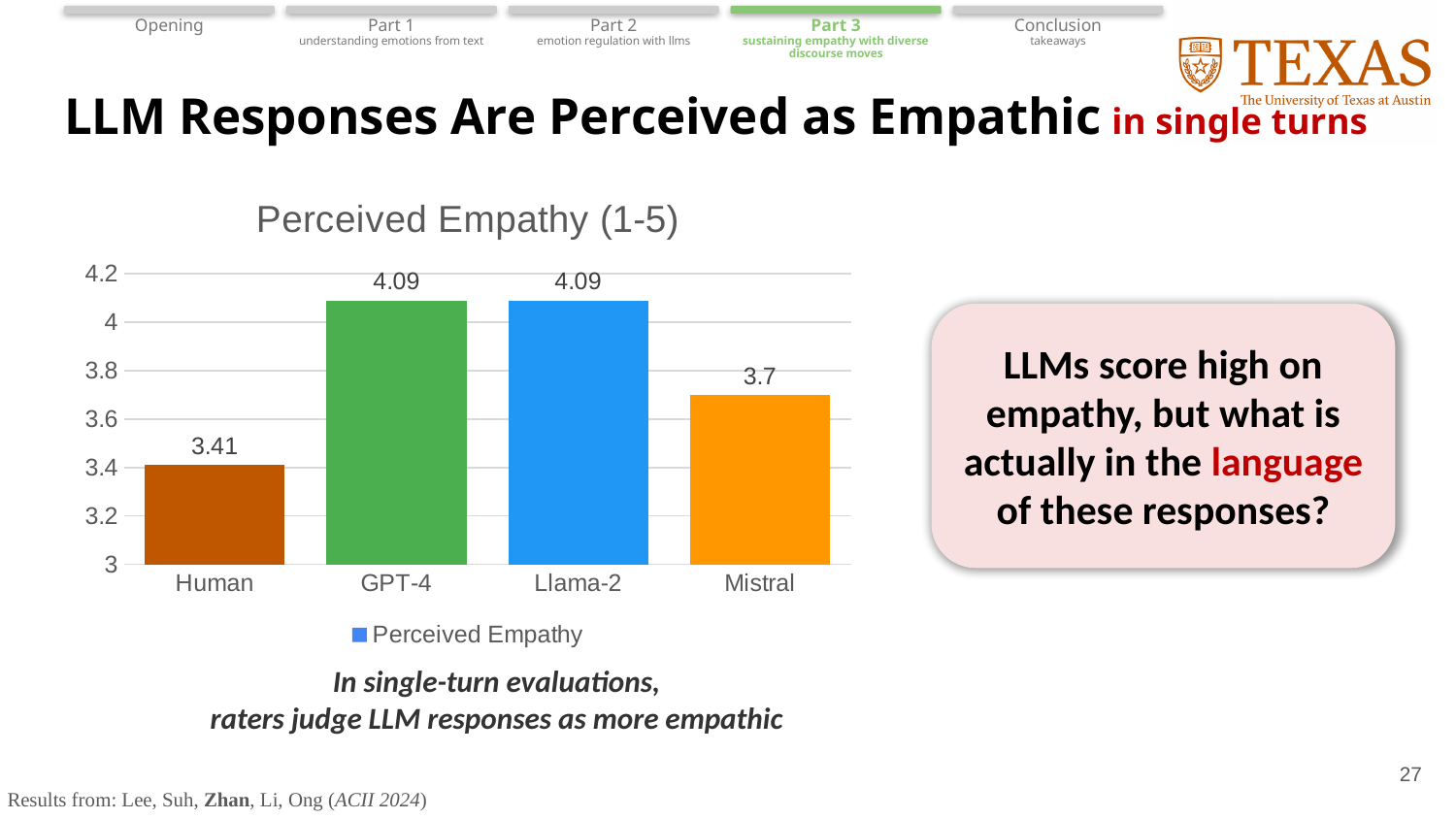
What is the perceived empathy score for Mistral? 3.7 Which category has the lowest perceived empathy score? Human How many series does the chart legend list? 1 What kind of chart is shown on the slide? bar chart What is the perceived empathy score for GPT-4? 4.09 Is the value for Mistral greater or less than 3.6? greater What is the difference between the perceived empathy scores of GPT-4 and Human? 0.68 What is the difference between the perceived empathy scores of Mistral and Human? 0.29 How many categories are shown on the x axis of the chart? 4 Which has a higher perceived empathy score, Llama-2 or Mistral? Llama-2 What is the title of the chart? Perceived Empathy (1-5) What is the perceived empathy score for Human? 3.41